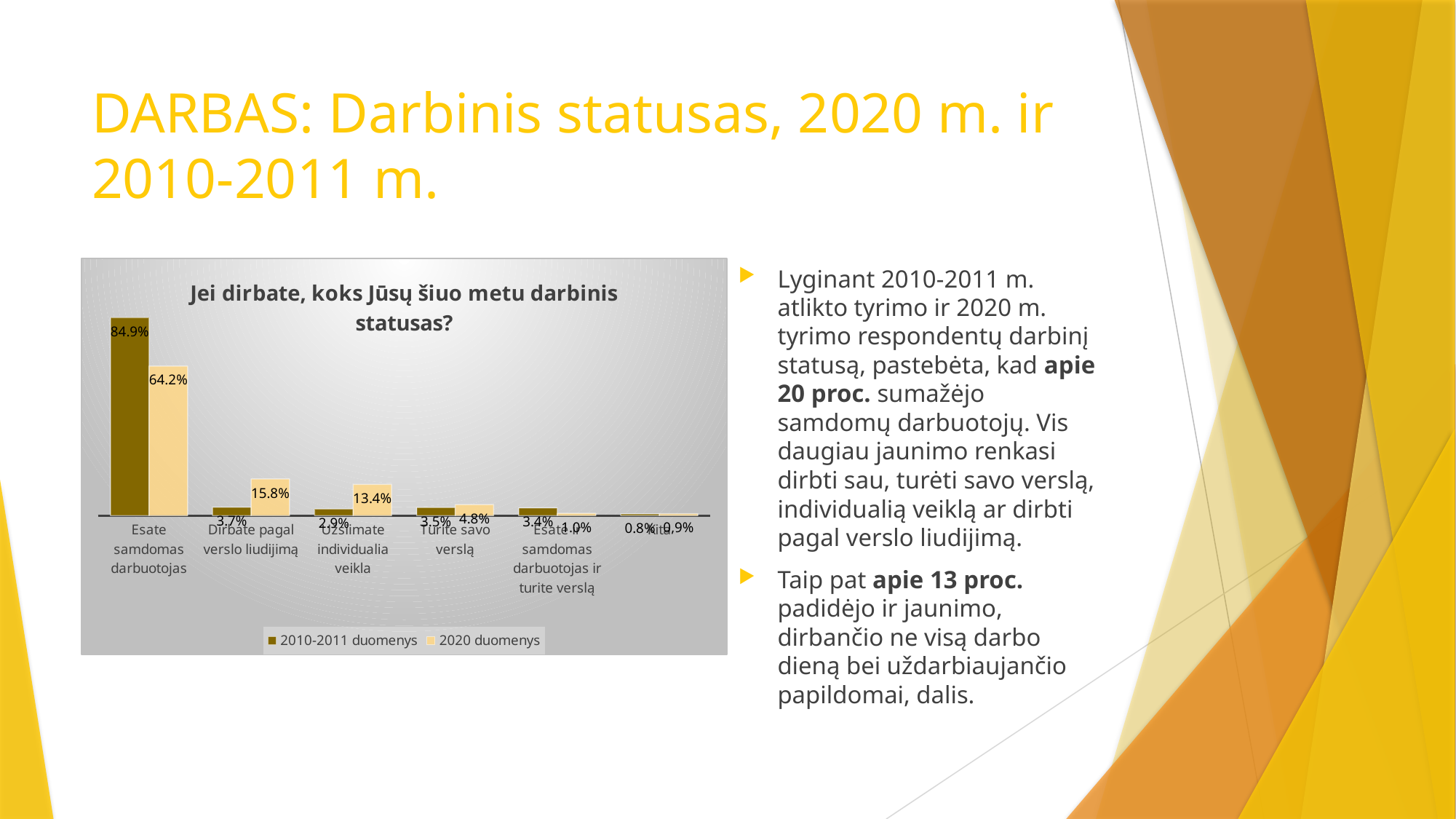
For 'Turite savo verslą', which series has the larger value: 2010-2011 duomenys or 2020 duomenys? 2020 duomenys What is the difference between the 2010-2011 duomenys and 2020 duomenys values for 'Esate samdomas darbuotojas'? 20.7% What is the title of the chart? Jei dirbate, koks Jūsų šiuo metu darbinis statusas? Which category has the highest 2020 duomenys value? Esate samdomas darbuotojas How many series does the chart legend list? 2 What is the 2020 duomenys value for 'Užsiimate individualia veikla'? 13.4% What type of chart is shown on the slide? bar chart What is the 2010-2011 duomenys value for 'Esate samdomas darbuotojas'? 84.9% Which category has the lowest 2010-2011 duomenys value? Kita How many categories are shown on the x axis of the chart? 6 What is the 2020 duomenys value for 'Dirbate pagal verslo liudijimą'? 15.8% What is the 2020 duomenys value for 'Esate samdomas darbuotojas'? 64.2%